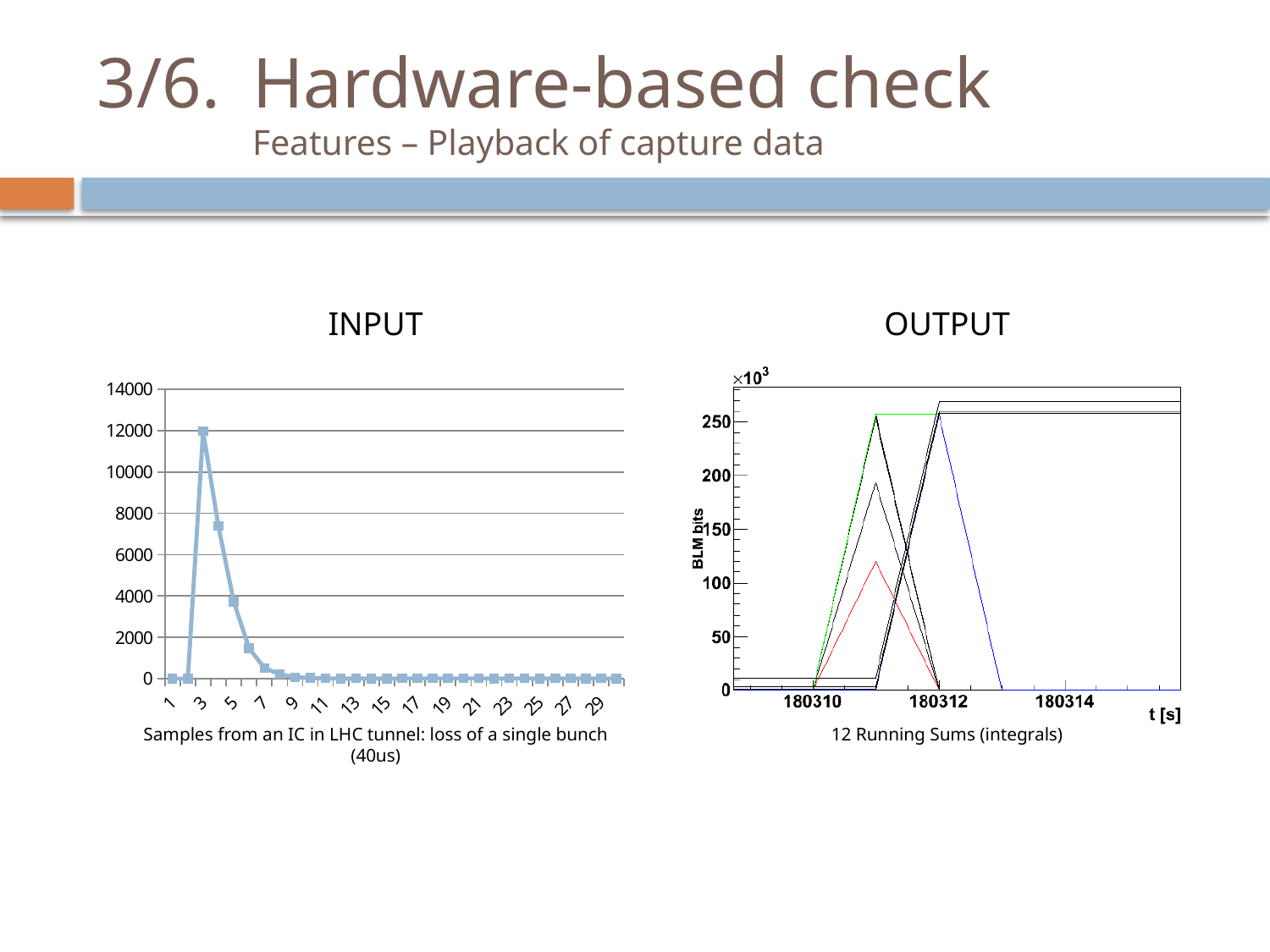
On the INPUT chart, is the value for sample 6 greater or less than 2000? less On the INPUT chart, what kind of chart is shown? line chart On the INPUT chart, what is the highest value shown on the y axis? 14000 On the INPUT chart, is the value for sample 4 greater or less than 8000? less On the OUTPUT chart, what is the label of the y axis? BLM bits On the INPUT chart, is the value for sample 1 greater or less than 2000? less On the INPUT chart, do the values rise or fall from sample 3 to sample 9? fall On the INPUT chart, which sample has the highest value? 3 On the INPUT chart, which is larger, the value for sample 3 or the value for sample 5? sample 3 On the OUTPUT chart, what is the label of the x axis? t [s]